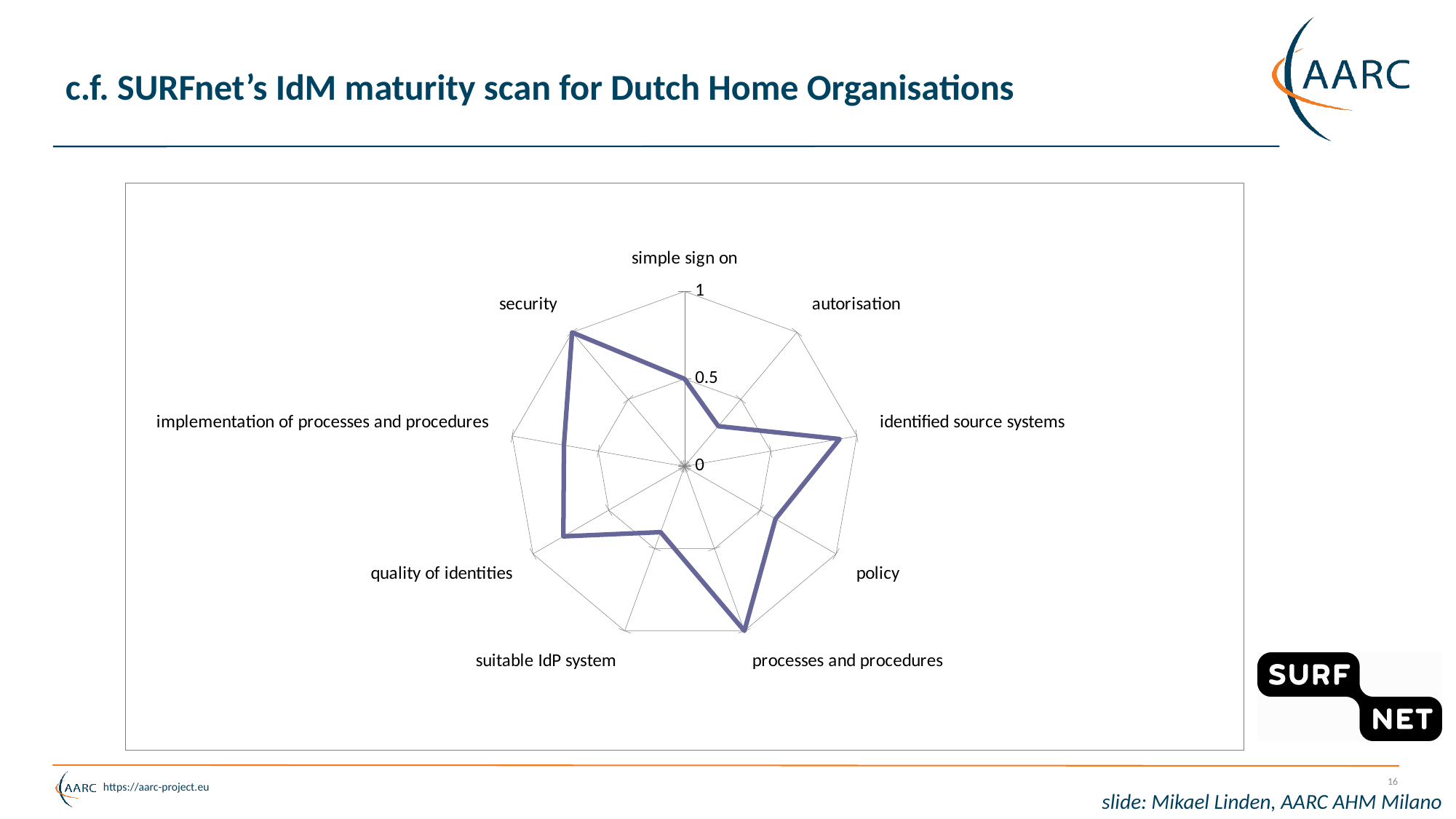
What is the maximum value shown on the radar chart's scale? 1 What kind of chart is shown on the slide? radar chart Which category has the lowest value on the radar chart? autorisation How many categories (axes) does the radar chart have? 9 Is the value for policy greater or less than 0.5? greater Is the value for quality of identities greater or less than 0.5? greater Which has the larger value, security or autorisation? security Is the value for security greater or less than 0.5? greater Which category has the highest value on the radar chart? processes and procedures and security (tied at 1) Which has the larger value, suitable IdP system or identified source systems? identified source systems